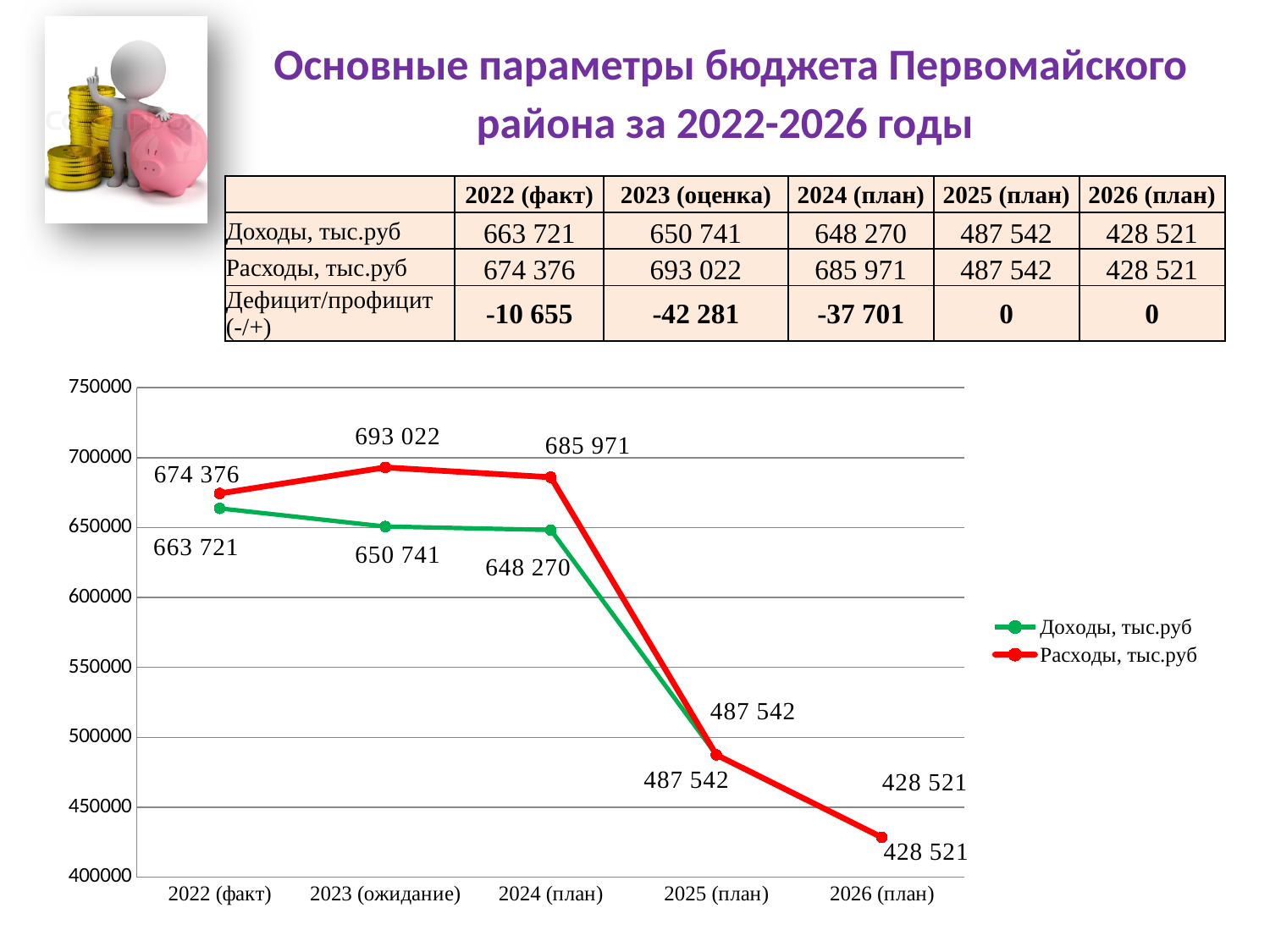
What is the value of Доходы, тыс.руб for 2024 (план)? 648 270 What is the difference between Расходы, тыс.руб and Доходы, тыс.руб for 2022 (факт)? 10 655 In which category is Доходы, тыс.руб lowest? 2026 (план) What is the value of Доходы, тыс.руб for 2026 (план)? 428 521 Which colour is used for the Расходы, тыс.руб line in the chart? red Does Доходы, тыс.руб rise or fall from 2022 (факт) to 2026 (план)? fall How many categories are shown on the x axis of the chart? 5 Which is larger for 2024 (план): Доходы, тыс.руб or Расходы, тыс.руб? Расходы, тыс.руб What is the value of Расходы, тыс.руб for 2023 (ожидание)? 693 022 How many series does the chart legend list? 2 In which category is Расходы, тыс.руб highest? 2023 (ожидание) What kind of chart is shown on the slide? line chart